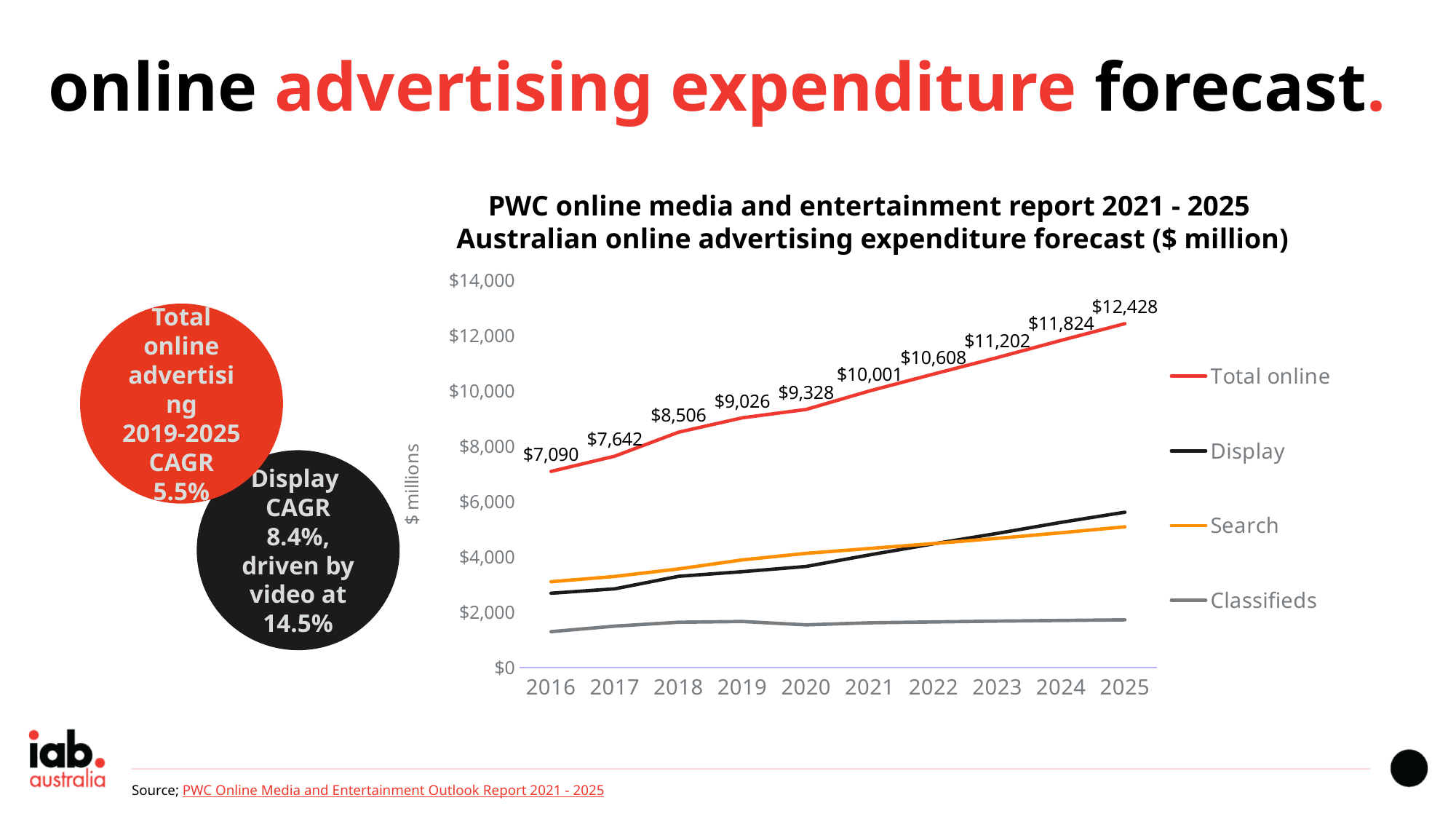
In which year is the Total online value lowest? 2016 How many series does the legend list? 4 Which series has the lowest values across all years? Classifieds What is the difference between the Total online values for 2025 and 2016? $5,338 Does the Total online series rise or fall from 2016 to 2025? rise What is the Total online value for 2025? $12,428 How many years are shown on the x axis? 10 In which year is the Total online value highest? 2025 What type of chart is shown on the slide? line chart What is the Total online value for 2021? $10,001 What is the Total online value for 2016? $7,090 Is the Classifieds value for 2025 greater or less than $2,000? less